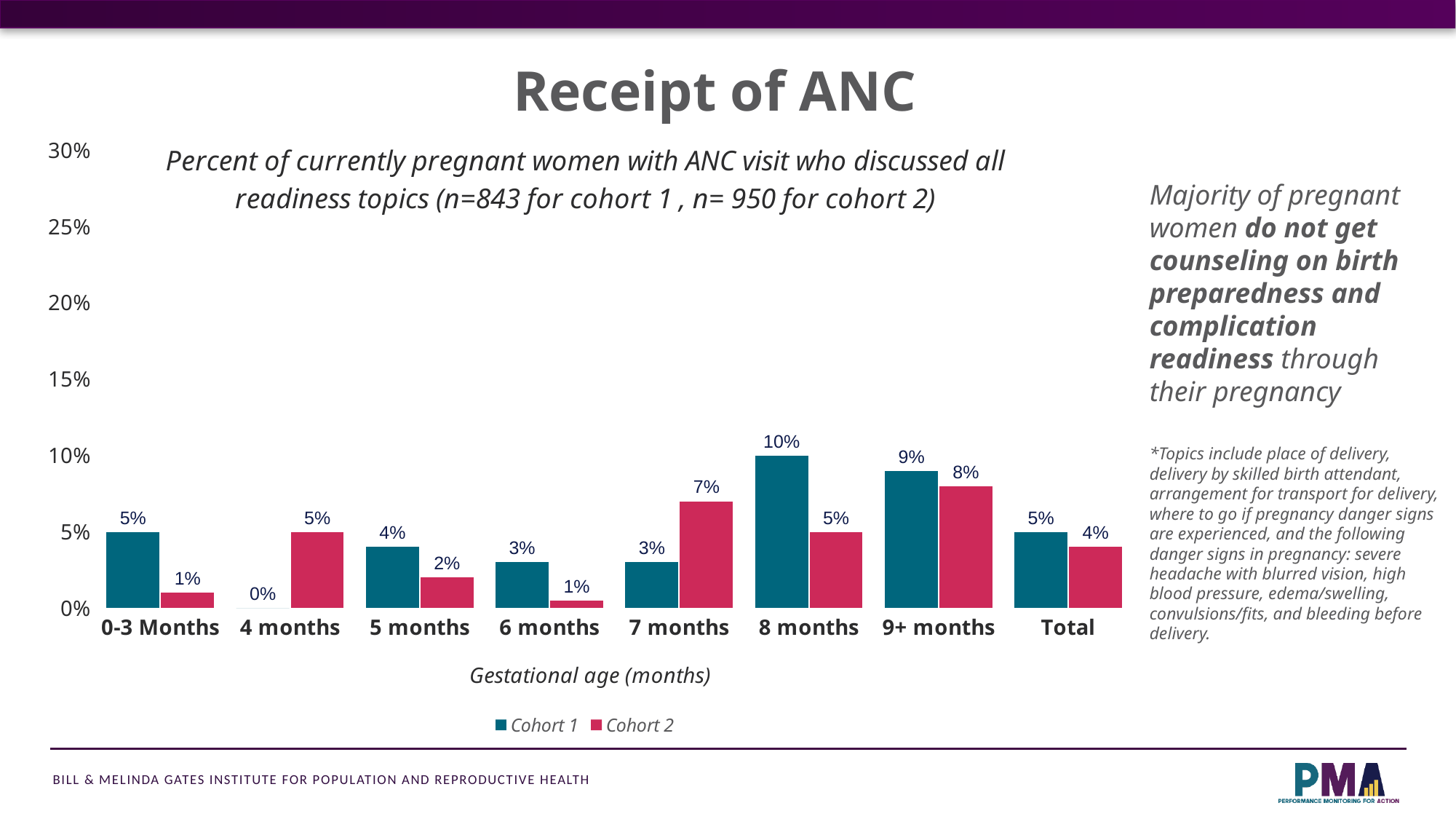
Which is larger at 7 months, Cohort 1 or Cohort 2? Cohort 2 What is the value for Cohort 1 at 4 months? 0% What is the value for Cohort 1 at 8 months? 10% What is the difference between Cohort 1 and Cohort 2 at 8 months? 5% What is the value for Cohort 2 at 7 months? 7% Which gestational age category has the highest value for Cohort 1? 8 months What kind of chart is shown on the slide? Bar chart Which gestational age category has the lowest value for Cohort 1? 4 months How many series does the legend list? 2 Which gestational age category has the highest value for Cohort 2? 9+ months How many categories are shown on the x axis? 8 What is the Total value for Cohort 2? 4%